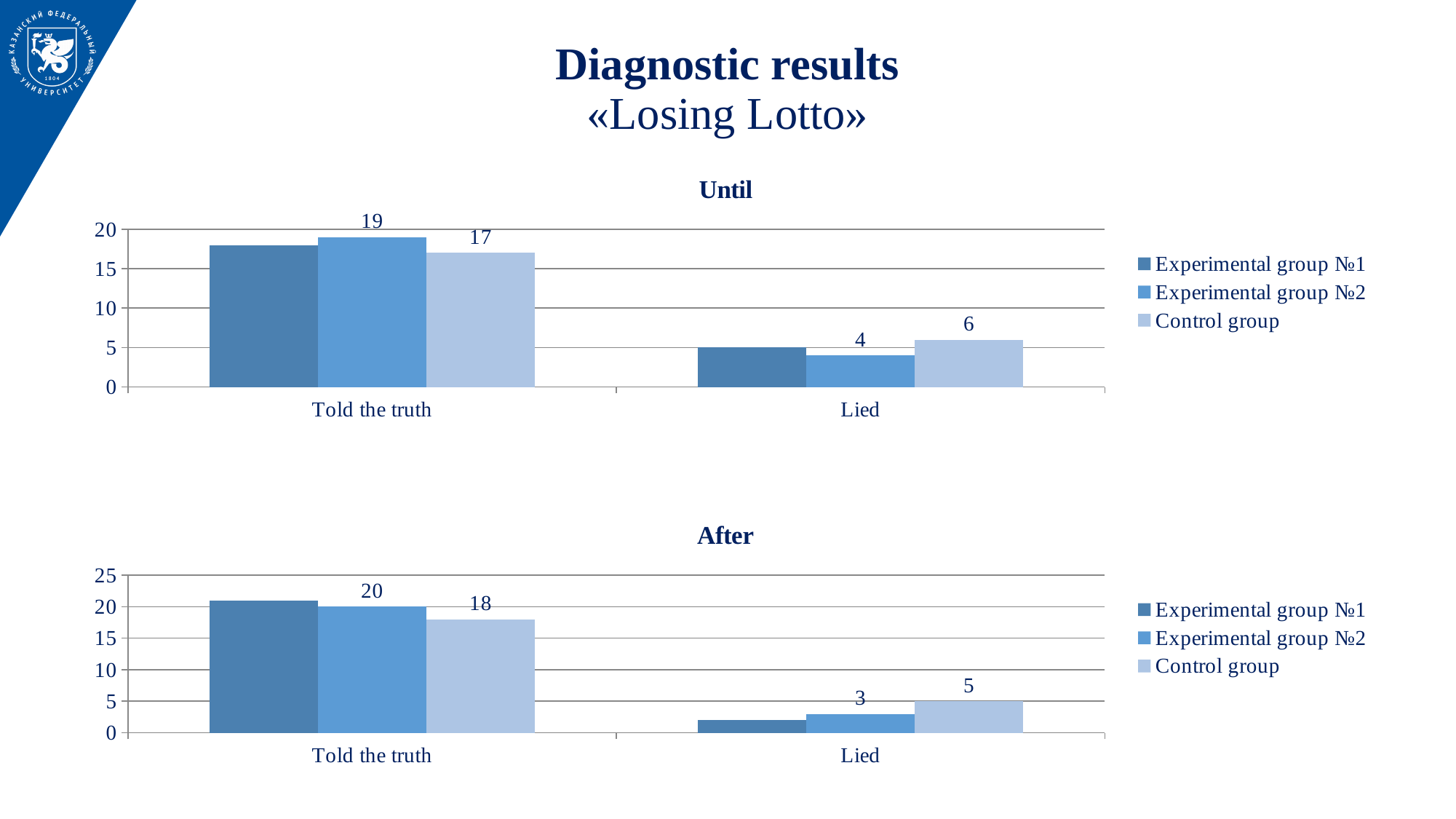
In the "After" chart, what is the value for Experimental group №2 in the "Told the truth" category? 20 In the "Until" chart, what is the value for Experimental group №2 in the "Told the truth" category? 19 In the "Until" chart, is the value for Experimental group №1 in the "Told the truth" category greater or less than 15? greater In the "After" chart, what is the difference between the Control group and Experimental group №2 in the "Lied" category? 2 In the "After" chart, what is the value for the Control group in the "Told the truth" category? 18 In the "After" chart, what is the value for the Control group in the "Lied" category? 5 In the "Until" chart, what is the difference between Experimental group №2 and the Control group in the "Told the truth" category? 2 In the "Until" chart, what is the value for the Control group in the "Lied" category? 6 In the "Until" chart, which is larger in the "Lied" category: Experimental group №2 or the Control group? Control group How many series does the legend of the "After" chart list? 3 In the "After" chart, is the value for Experimental group №1 in the "Lied" category greater or less than 5? less What kind of chart is the "Until" chart? bar chart